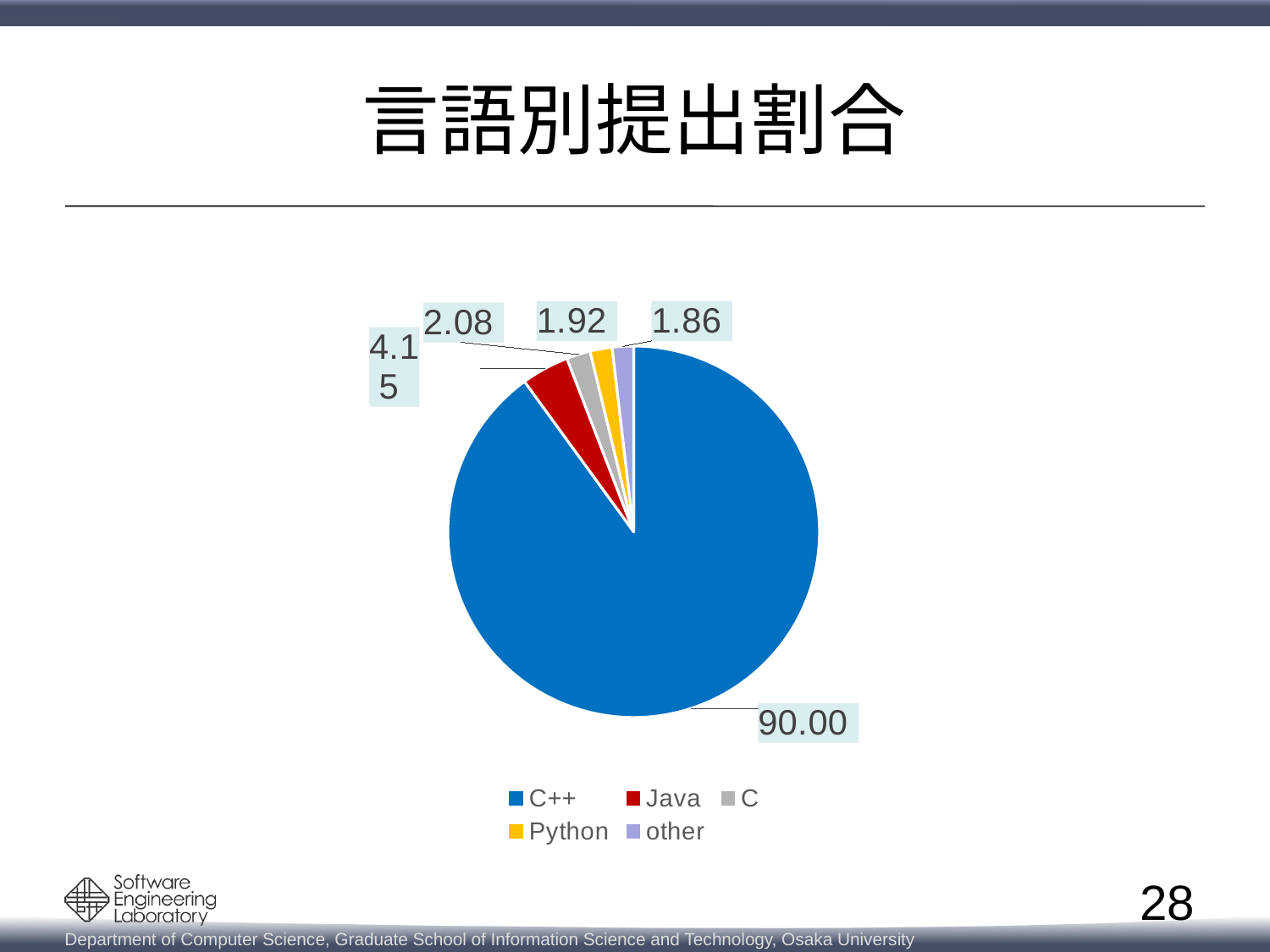
What is the difference between the C++ value and the Java value? 85.85 What is the value shown for the C slice? 2.08 Which language has the largest slice of the pie? C++ Which slice is larger, Java or C? Java What is the value shown for the Python slice? 1.92 What type of chart is shown on the slide? pie chart Which category has the smallest slice of the pie? other How many categories does the legend list? 5 What is the value shown for the 'other' slice? 1.86 What colour is the Java slice in the pie chart? red What is the value shown for the C++ slice? 90.00 What is the value shown for the Java slice? 4.15